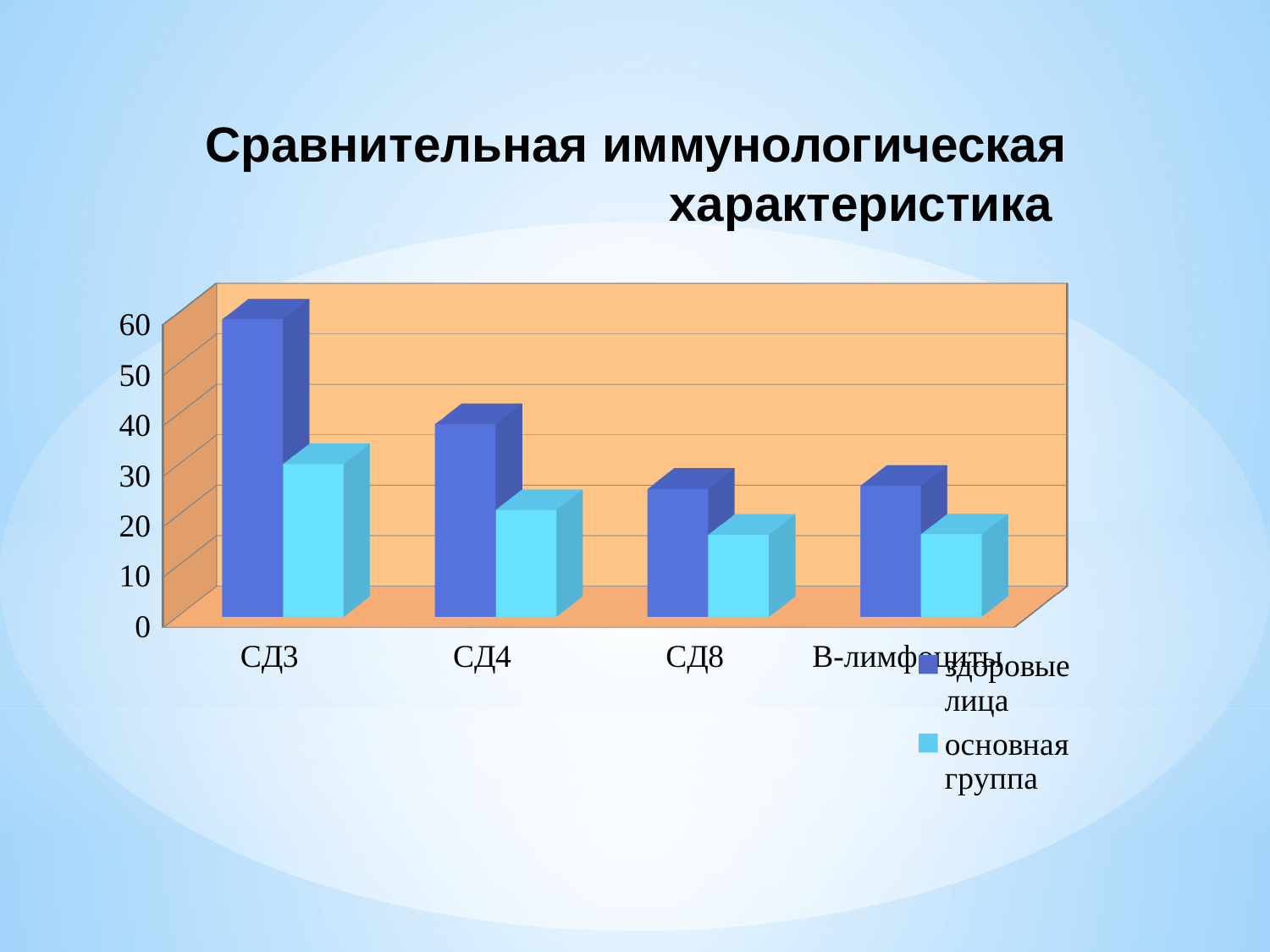
How many series does the chart legend list? 2 What is the title of the slide containing the chart? Сравнительная иммунологическая характеристика Which category has the highest value for the series 'здоровые лица'? СД3 What kind of chart is shown on the slide? bar chart Which category has the highest value for the series 'основная группа'? СД3 How many categories are shown on the x axis of the chart? 4 For the series 'здоровые лица', which is larger: the value at СД3 or the value at СД4? СД3 For the category СД3, which series has the larger value: 'здоровые лица' or 'основная группа'? здоровые лица Is the value for 'основная группа' at СД3 greater or less than 20? greater Is the value for 'основная группа' at СД8 greater or less than 20? less Is the value for 'здоровые лица' at СД3 greater or less than 50? greater